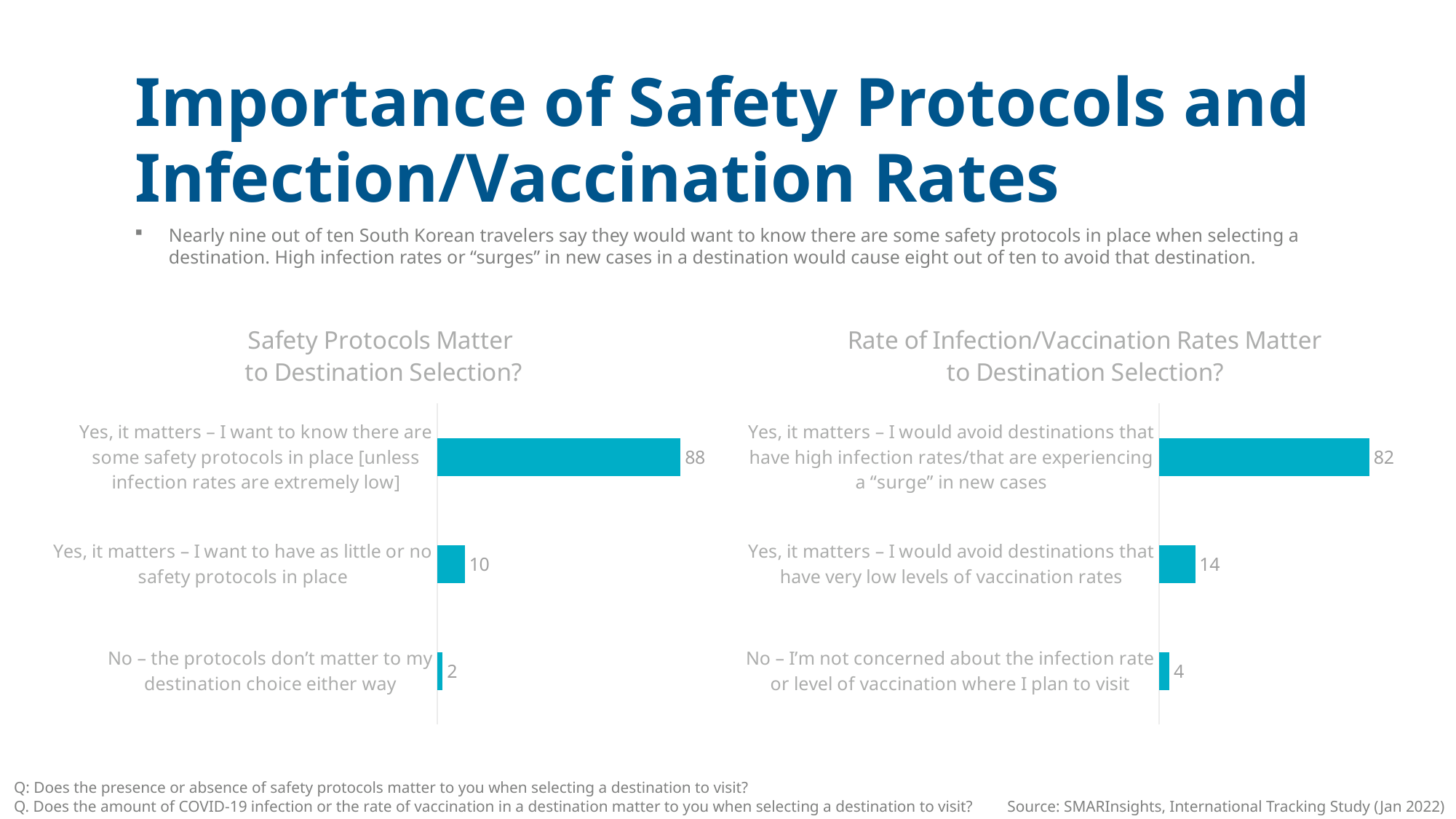
Which is larger: the value for 'I want to have as little or no safety protocols in place' in the left chart, or the value for 'I would avoid destinations that have very low levels of vaccination rates' in the right chart? I would avoid destinations that have very low levels of vaccination rates (14) In the 'Rate of Infection/Vaccination Rates Matter to Destination Selection?' chart, what is the value for 'No – I'm not concerned about the infection rate or level of vaccination where I plan to visit'? 4 In the 'Rate of Infection/Vaccination Rates Matter to Destination Selection?' chart, which category has the lowest value? No – I'm not concerned about the infection rate or level of vaccination where I plan to visit In the 'Rate of Infection/Vaccination Rates Matter to Destination Selection?' chart, what is the value for 'Yes, it matters – I would avoid destinations that have very low levels of vaccination rates'? 14 In the 'Safety Protocols Matter to Destination Selection?' chart, what is the value for 'No – the protocols don't matter to my destination choice either way'? 2 In the 'Safety Protocols Matter to Destination Selection?' chart, what is the value for 'Yes, it matters – I want to know there are some safety protocols in place'? 88 In the 'Rate of Infection/Vaccination Rates Matter to Destination Selection?' chart, what is the difference between the values for avoiding destinations with high infection rates and avoiding destinations with very low vaccination rates? 68 How many categories are shown in the 'Safety Protocols Matter to Destination Selection?' chart? 3 In the 'Safety Protocols Matter to Destination Selection?' chart, what is the difference between the values for 'I want to know there are some safety protocols in place' and 'I want to have as little or no safety protocols in place'? 78 What is the title of the chart on the left side of the slide? Safety Protocols Matter to Destination Selection? What type of chart is the 'Rate of Infection/Vaccination Rates Matter to Destination Selection?' chart? Bar chart In the 'Safety Protocols Matter to Destination Selection?' chart, which category has the highest value? Yes, it matters – I want to know there are some safety protocols in place [unless infection rates are extremely low]